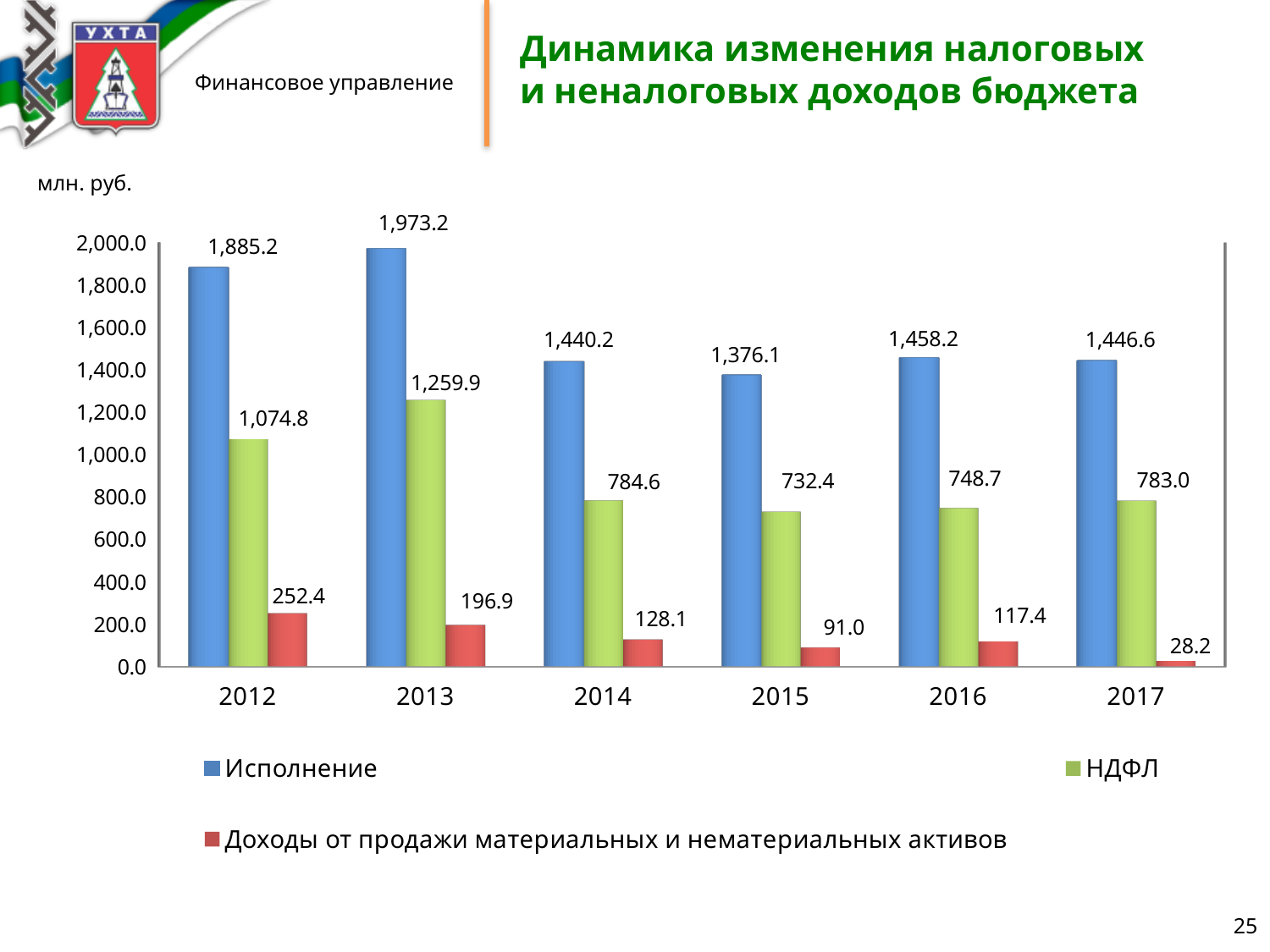
What unit is indicated above the chart? млн. руб. Which is larger: НДФЛ in 2014 or НДФЛ in 2016? НДФЛ in 2014 What is the difference between Исполнение and НДФЛ in 2013? 713.3 What is the value of Доходы от продажи материальных и нематериальных активов for 2017? 28.2 In which year is Исполнение highest? 2013 What kind of chart is shown on the slide? Bar chart In which year is Доходы от продажи материальных и нематериальных активов lowest? 2017 What is the value of Исполнение for 2013? 1,973.2 How many series does the legend list? 3 What is the value of НДФЛ for 2015? 732.4 By how much did Доходы от продажи материальных и нематериальных активов fall from 2012 to 2017? 224.2 How many years are shown on the x axis? 6